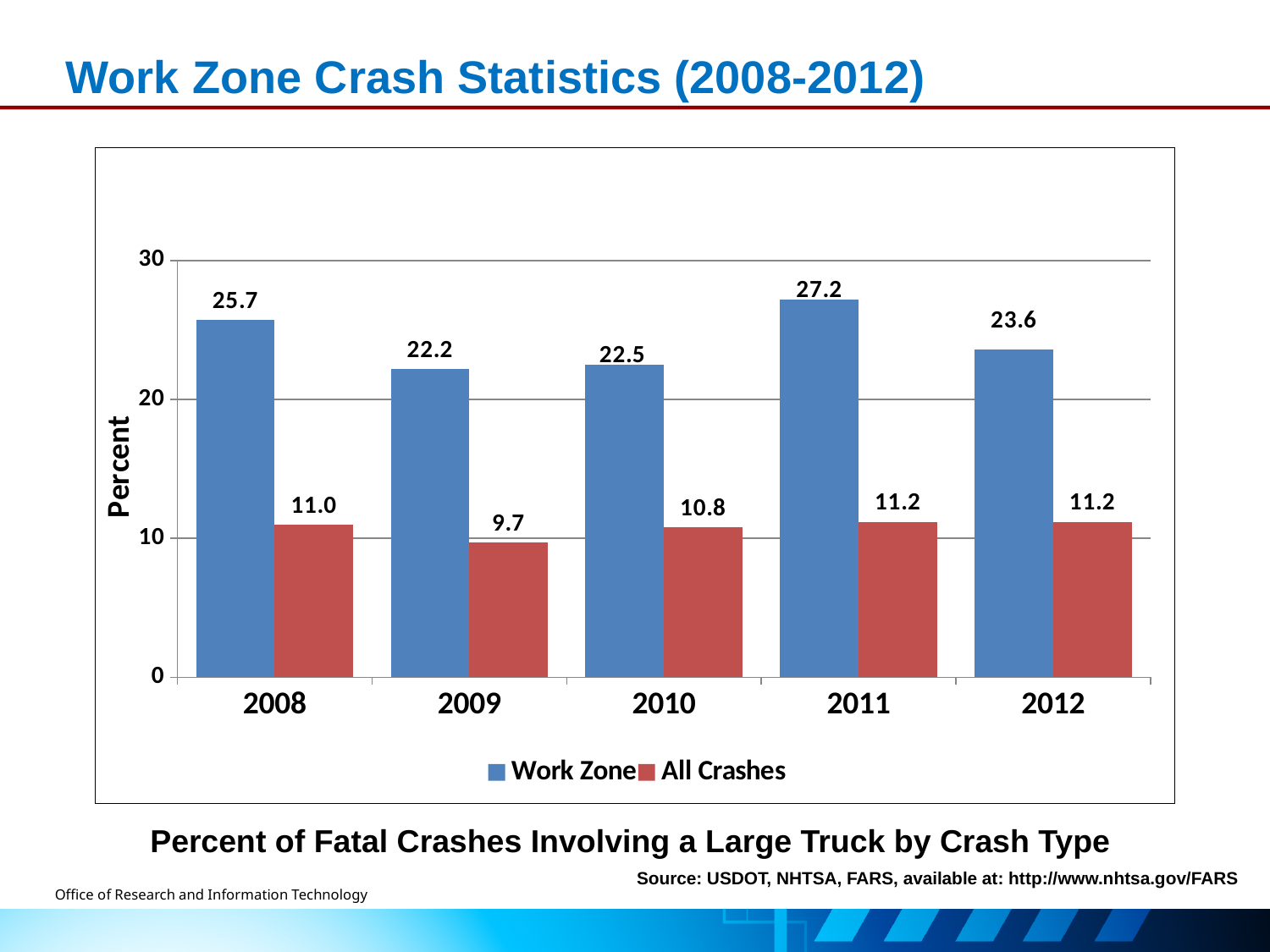
What is the difference between the Work Zone and All Crashes values in 2008? 14.7 What is the label on the y axis? Percent How many series does the legend list? 2 How many years are shown on the x axis? 5 What is the All Crashes value for 2009? 9.7 Which is larger, the Work Zone value for 2009 or the Work Zone value for 2012? 2012 What kind of chart is shown on the slide? Bar chart Which series is shown in red? All Crashes Is the Work Zone value for 2010 greater or less than 20? greater Which year has the lowest All Crashes value? 2009 Which year has the highest Work Zone value? 2011 What is the Work Zone value for 2011? 27.2